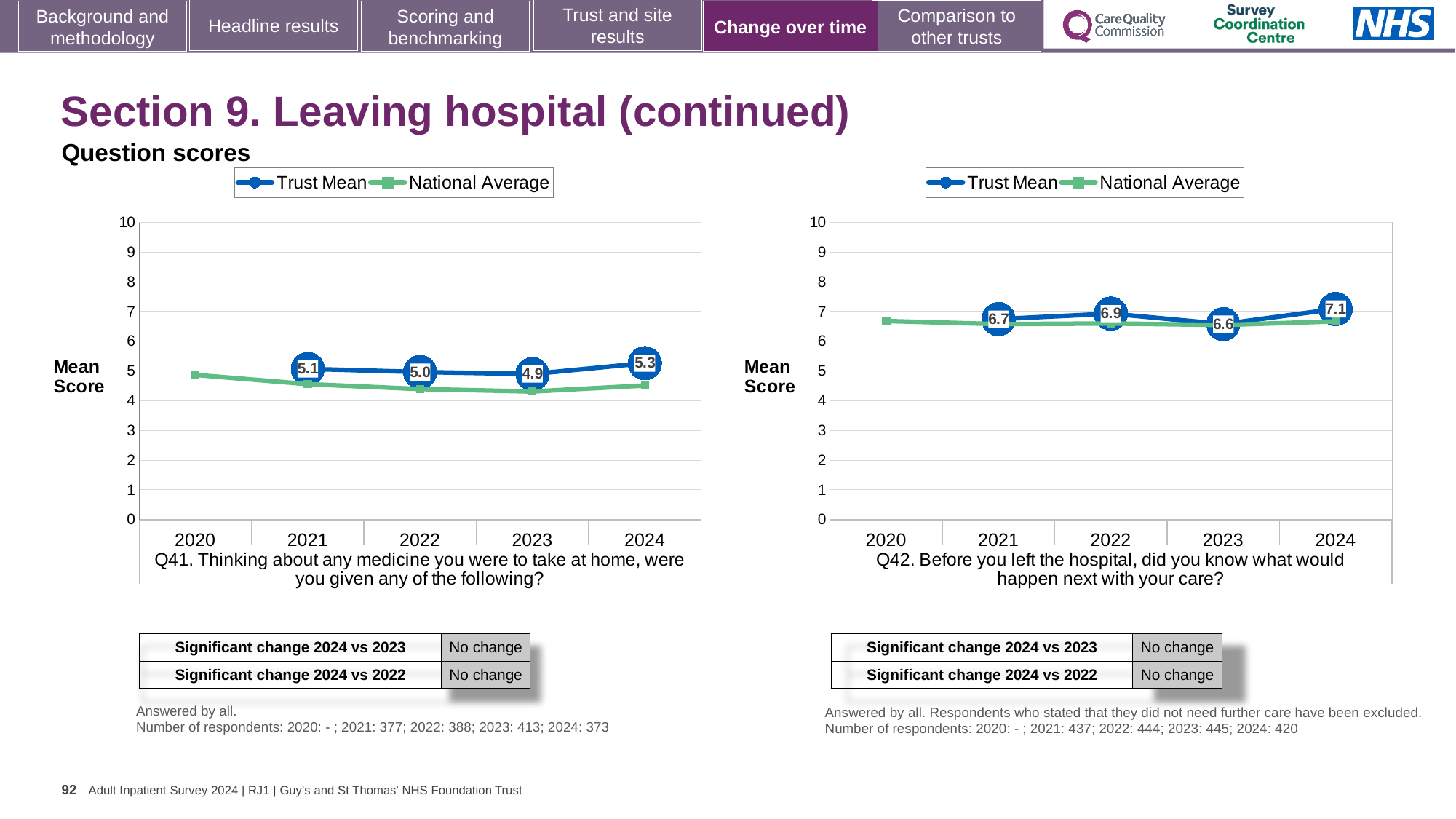
What kind of chart is the Q42 chart on the right? Line chart In the Q42 chart on the right, which year has the highest Trust Mean score? 2024 In the Q41 chart on the left, which year has the lowest Trust Mean score? 2023 In the Q42 chart on the right, what is the Trust Mean score for 2022? 6.9 In the Q41 chart on the left, what is the Trust Mean score for 2023? 4.9 In the Q41 chart on the left, is the Trust Mean score higher in 2021 or in 2022? 2021 How many series does the legend of the Q42 chart on the right list? 2 In the Q41 chart on the left, what is the Trust Mean score for 2024? 5.3 In the Q41 chart on the left, is the National Average value for 2023 greater or less than 5? less In the Q42 chart on the right, what is the difference between the Trust Mean scores for 2024 and 2023? 0.5 In the Q42 chart on the right, does the Trust Mean rise or fall from 2023 to 2024? Rise How many years are shown on the x axis of the Q41 chart on the left? 5